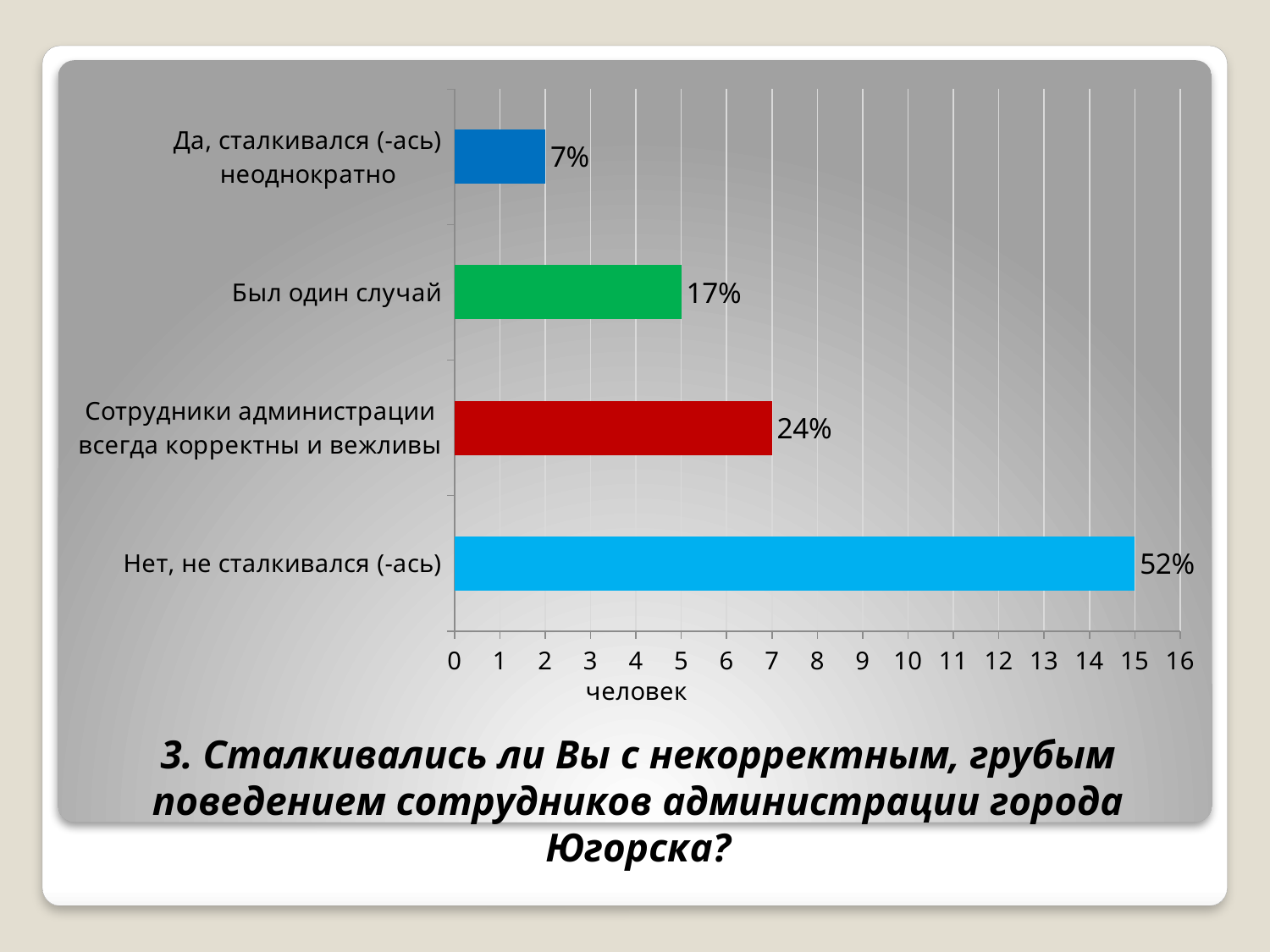
What data label is shown for the bar "Да, сталкивался (-ась) неоднократно"? 7% Which category has the highest value? Нет, не сталкивался (-ась) What is the difference in percentage points between "Нет, не сталкивался (-ась)" and "Сотрудники администрации всегда корректны и вежливы"? 28 What data label is shown for the bar "Нет, не сталкивался (-ась)"? 52% How many people (человек) does the bar "Да, сталкивался (-ась) неоднократно" reach on the x axis? 2 Which category has the lowest value? Да, сталкивался (-ась) неоднократно How many people (человек) does the bar "Нет, не сталкивался (-ась)" reach on the x axis? 15 What data label is shown for the bar "Сотрудники администрации всегда корректны и вежливы"? 24% What kind of chart is shown on the slide? Bar chart What data label is shown for the bar "Был один случай"? 17% Which is larger: the value for "Был один случай" or for "Сотрудники администрации всегда корректны и вежливы"? Сотрудники администрации всегда корректны и вежливы How many categories are shown in the chart? 4